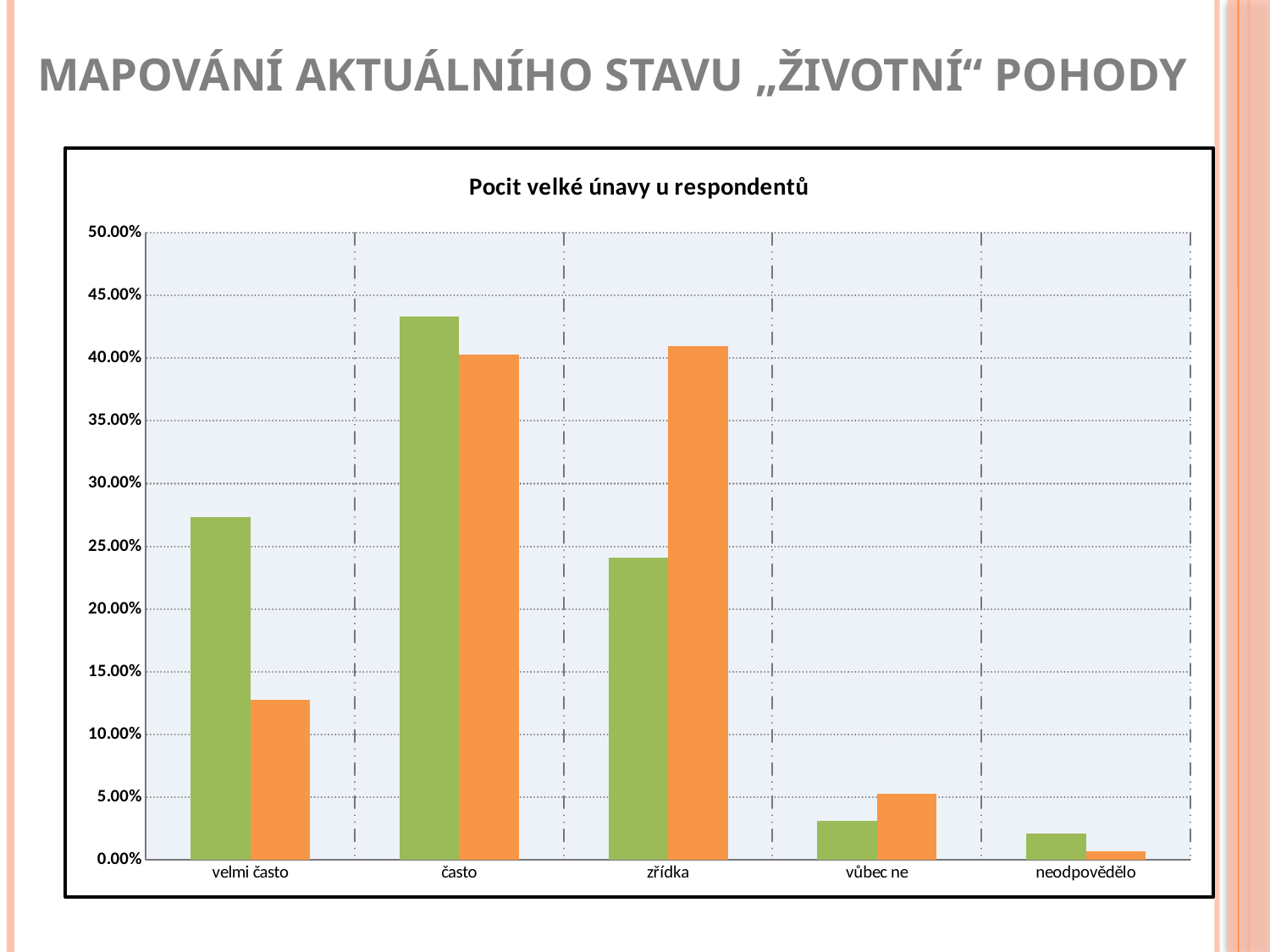
Is the green bar for 'velmi často' greater or less than 25.00%? greater What is the title of the chart? Pocit velké únavy u respondentů Is the orange bar for 'velmi často' greater or less than 15.00%? less Which category has the tallest green bar? často Which category has the shortest orange bar? neodpovědělo How many categories are shown on the x axis of the chart? 5 For the category 'velmi často', which bar is taller, the green one or the orange one? green Which category has the shortest green bar? neodpovědělo Is the green bar for 'vůbec ne' greater or less than 5.00%? less What kind of chart is shown on the slide? bar chart For the category 'zřídka', which bar is taller, the green one or the orange one? orange How many bars are plotted for each category in the chart? 2